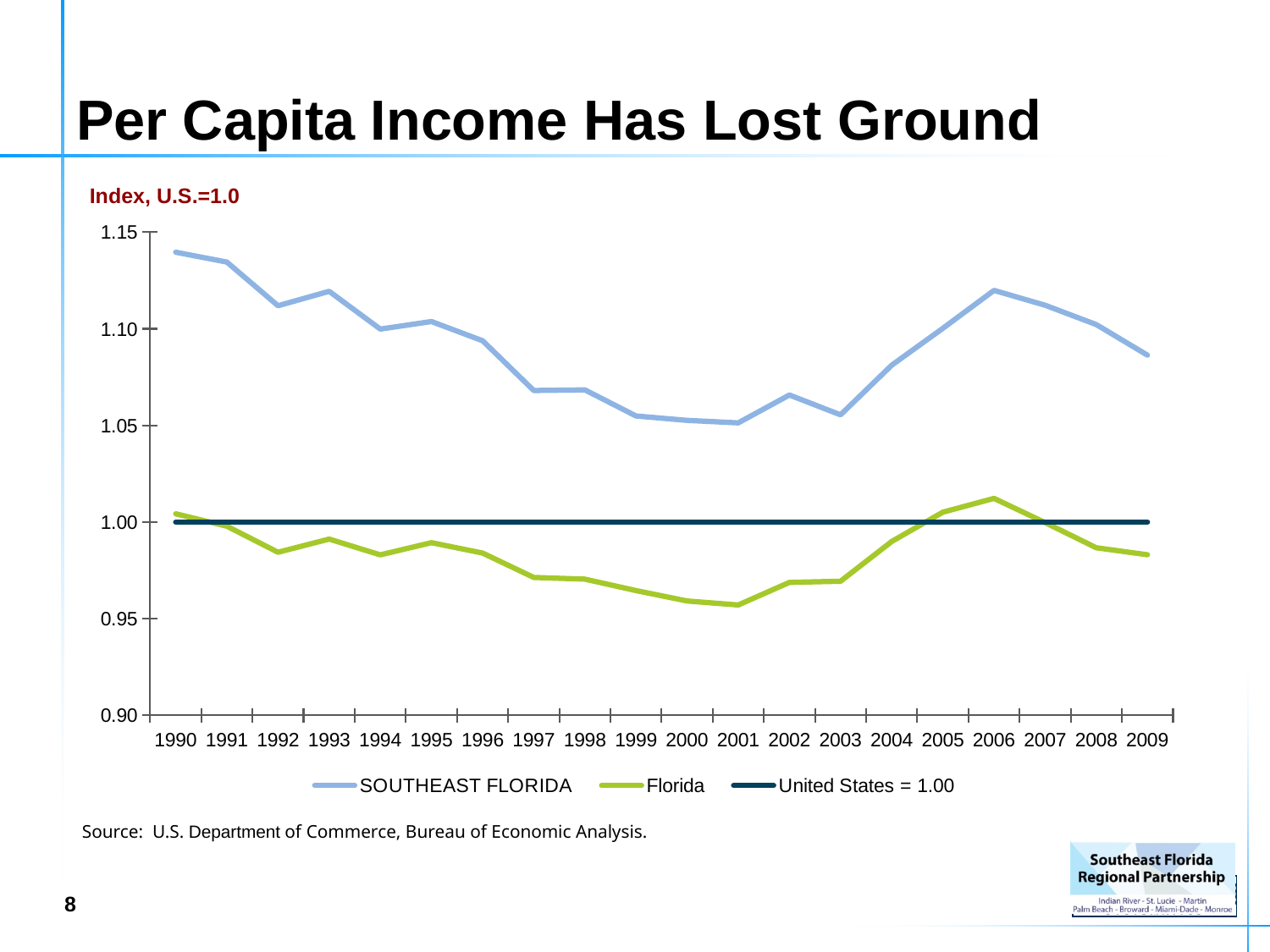
Is the value for SOUTHEAST FLORIDA in 1990 greater or less than 1.10? greater Is the value for SOUTHEAST FLORIDA in 2009 greater or less than 1.10? less How many years are plotted along the x axis? 20 What kind of chart is shown on the slide? line chart Is the value for Florida in 1992 greater or less than 1.00? less What is the title of the slide? Per Capita Income Has Lost Ground Which is larger for SOUTHEAST FLORIDA, the value in 1990 or the value in 2009? 1990 What value does the United States line sit at throughout the chart? 1.00 Which is larger for Florida, the value in 2006 or the value in 2001? 2006 Does the SOUTHEAST FLORIDA line rise or fall between 2001 and 2006? rise How many series does the legend list? 3